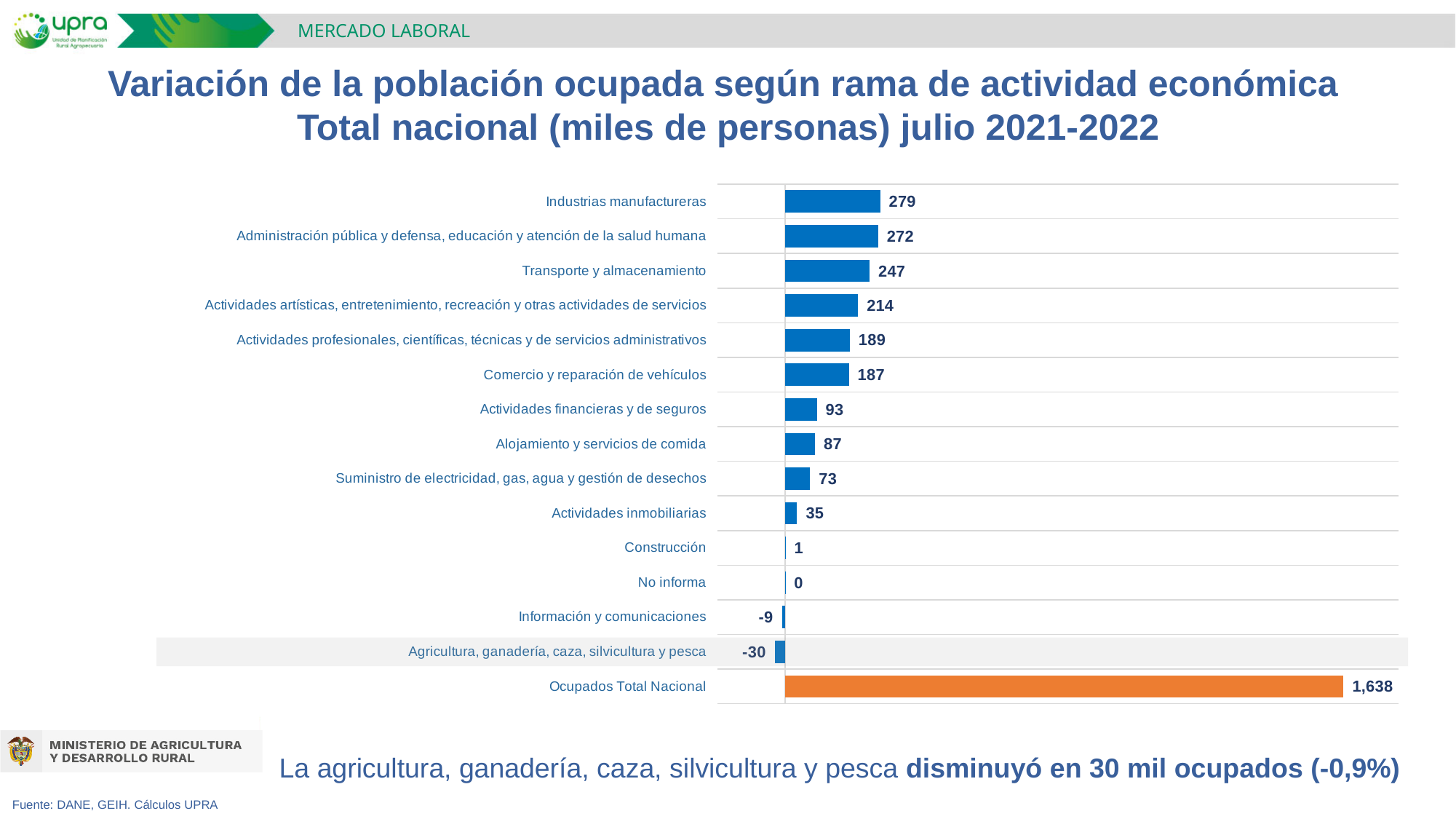
What is the value for Ocupados Total Nacional? 1,638 Which bar is shown in orange rather than blue? Ocupados Total Nacional Which is larger, Actividades inmobiliarias or Suministro de electricidad, gas, agua y gestión de desechos? Suministro de electricidad, gas, agua y gestión de desechos What is the value for Información y comunicaciones? -9 What is the value for Actividades financieras y de seguros? 93 What is the value for Agricultura, ganadería, caza, silvicultura y pesca? -30 What is the difference between Industrias manufactureras and Transporte y almacenamiento? 32 What is the value for Industrias manufactureras? 279 What kind of chart is shown on the slide? Bar chart How many categories are shown in the chart? 15 Excluding Ocupados Total Nacional, which category has the highest value? Industrias manufactureras Which category has the lowest value? Agricultura, ganadería, caza, silvicultura y pesca